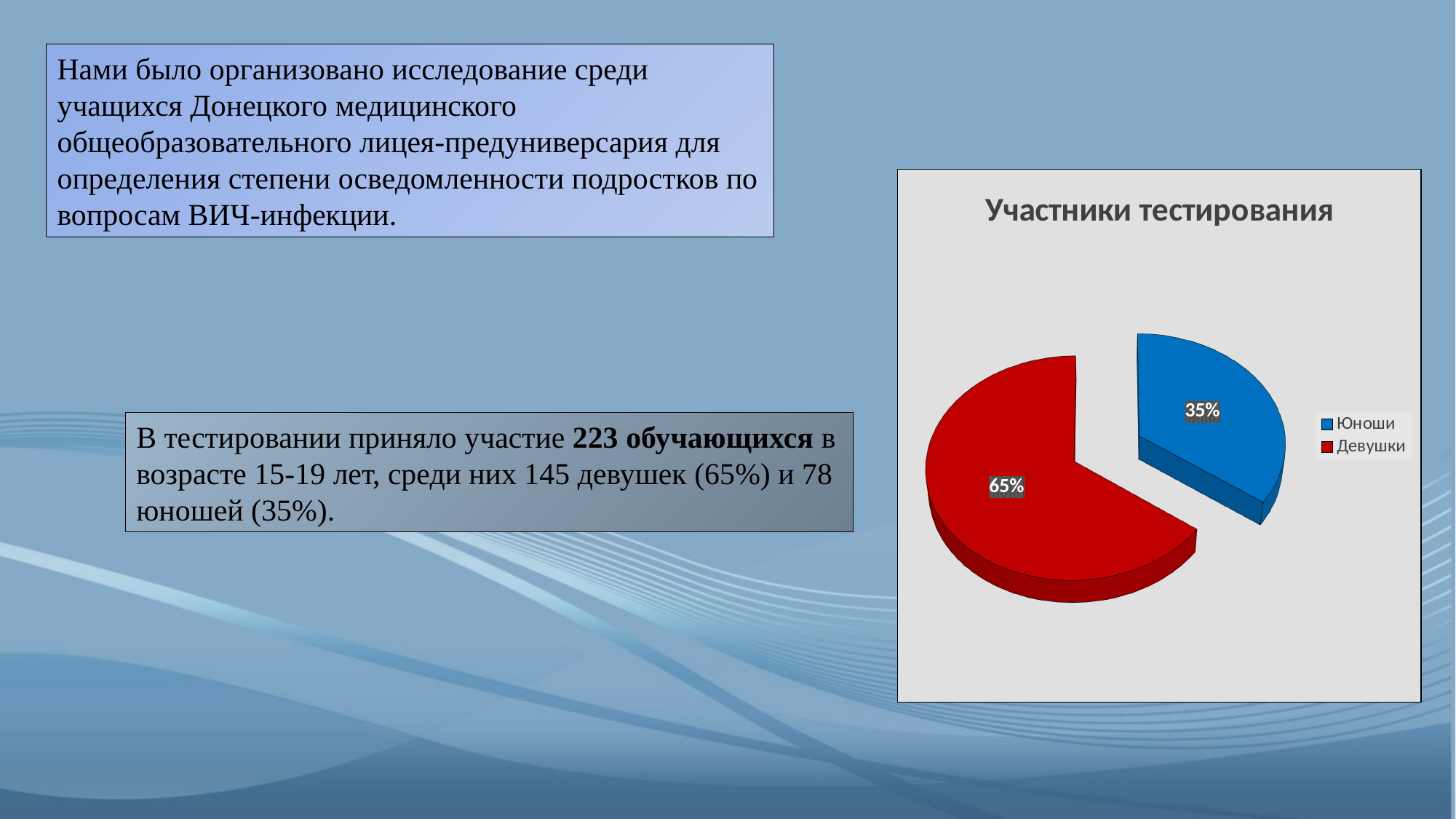
What share of the pie does Девушки represent? 65% How many categories does the pie chart show? 2 What kind of chart is shown on the slide? Pie chart Which category has the largest slice of the pie? Девушки What share of the pie does Юноши represent? 35% Which slice is larger, Юноши or Девушки? Девушки How many entries does the legend list? 2 What is the title of the chart? Участники тестирования Which category has the smallest slice of the pie? Юноши What is the difference in percentage points between the Девушки and Юноши slices? 30% What colour is the Девушки slice? Red